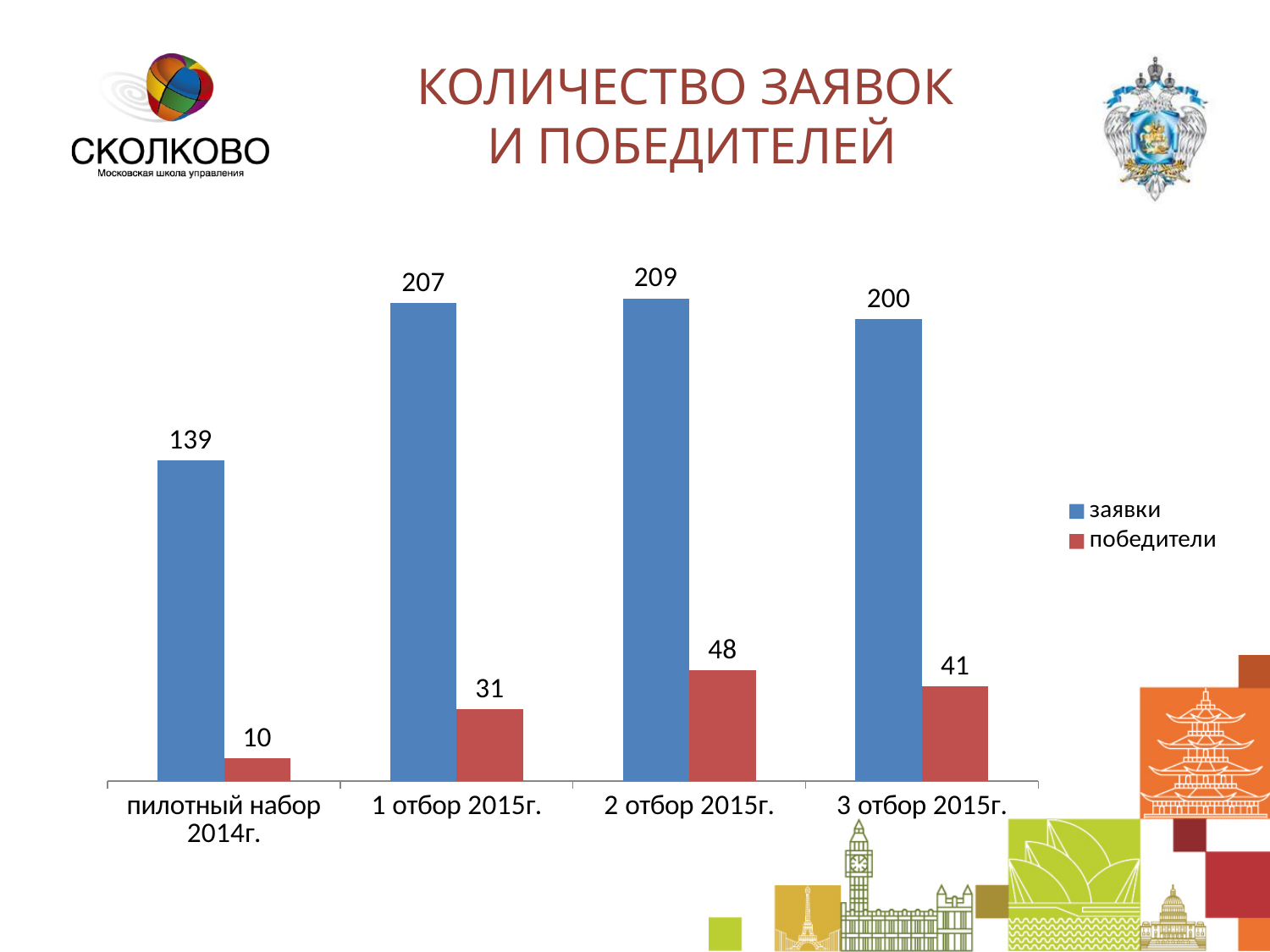
What is the value of победители for 3 отбор 2015г.? 41 How many categories are shown on the x axis? 4 Which is larger: заявки for 1 отбор 2015г. or заявки for 3 отбор 2015г.? 1 отбор 2015г. Which series is shown in red in the legend? победители What is the difference between победители for 2 отбор 2015г. and победители for 1 отбор 2015г.? 17 What is the value of заявки for 1 отбор 2015г.? 207 What kind of chart is shown on the slide? bar chart Which category has the highest value for победители? 2 отбор 2015г. Which category has the lowest value for заявки? пилотный набор 2014г. What is the difference between заявки for 2 отбор 2015г. and заявки for пилотный набор 2014г.? 70 What is the value of победители for пилотный набор 2014г.? 10 How many series does the legend list? 2